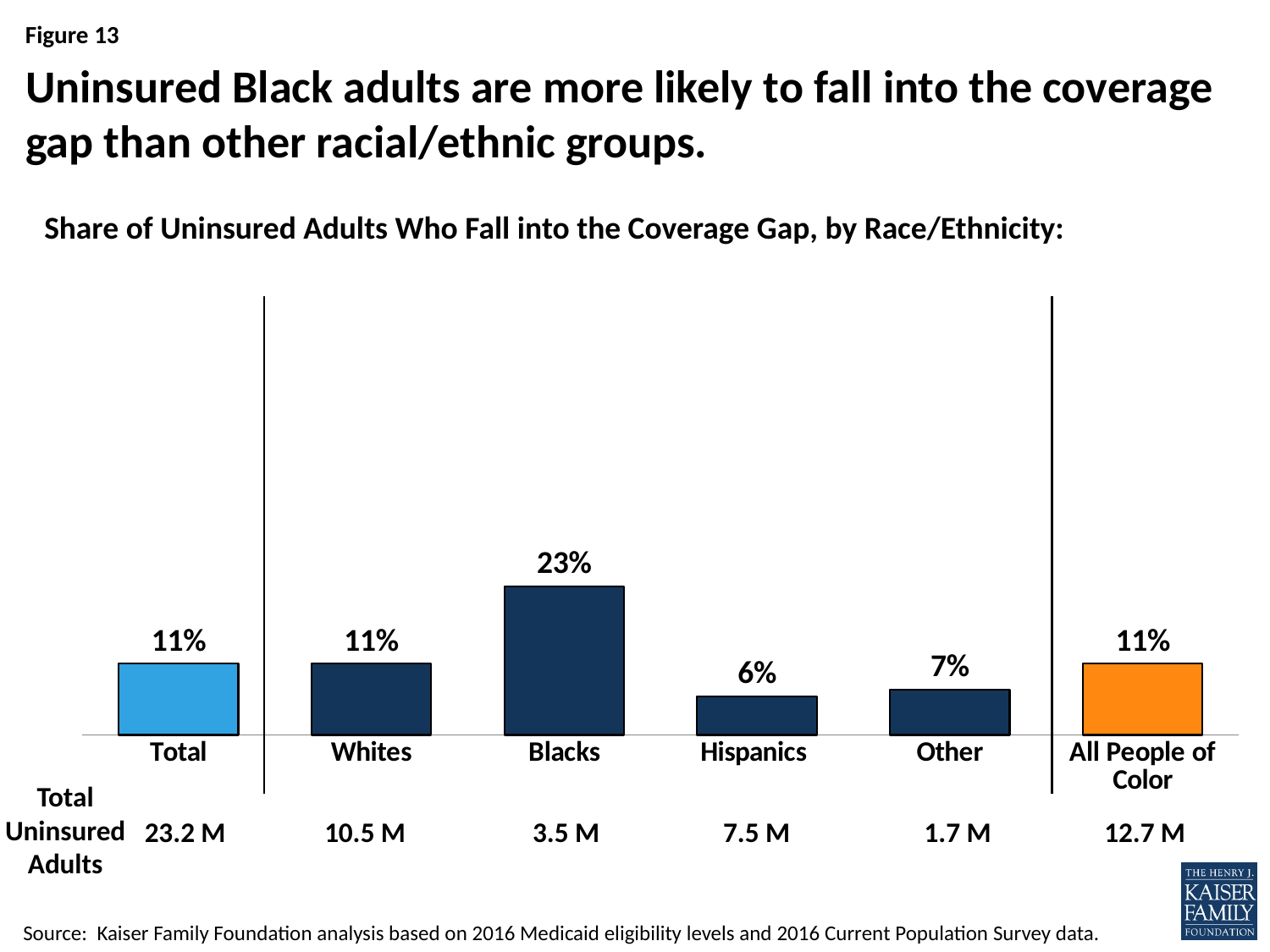
What is the total number of uninsured adults listed below the Blacks bar? 3.5 M What share of uninsured Hispanic adults fall into the coverage gap? 6% What is the value shown for the Other category? 7% How many categories are shown on the chart? 6 Which is larger, the share for Hispanics or the share for Other? Other What share of uninsured Black adults fall into the coverage gap? 23% What kind of chart is shown on the slide? Bar chart Which category has the lowest share of uninsured adults falling into the coverage gap? Hispanics Which category has the highest share of uninsured adults falling into the coverage gap? Blacks What colour is the bar for All People of Color? Orange What is the difference in percentage points between the share for Blacks and the share for Whites? 12 What is the value shown for All People of Color? 11%